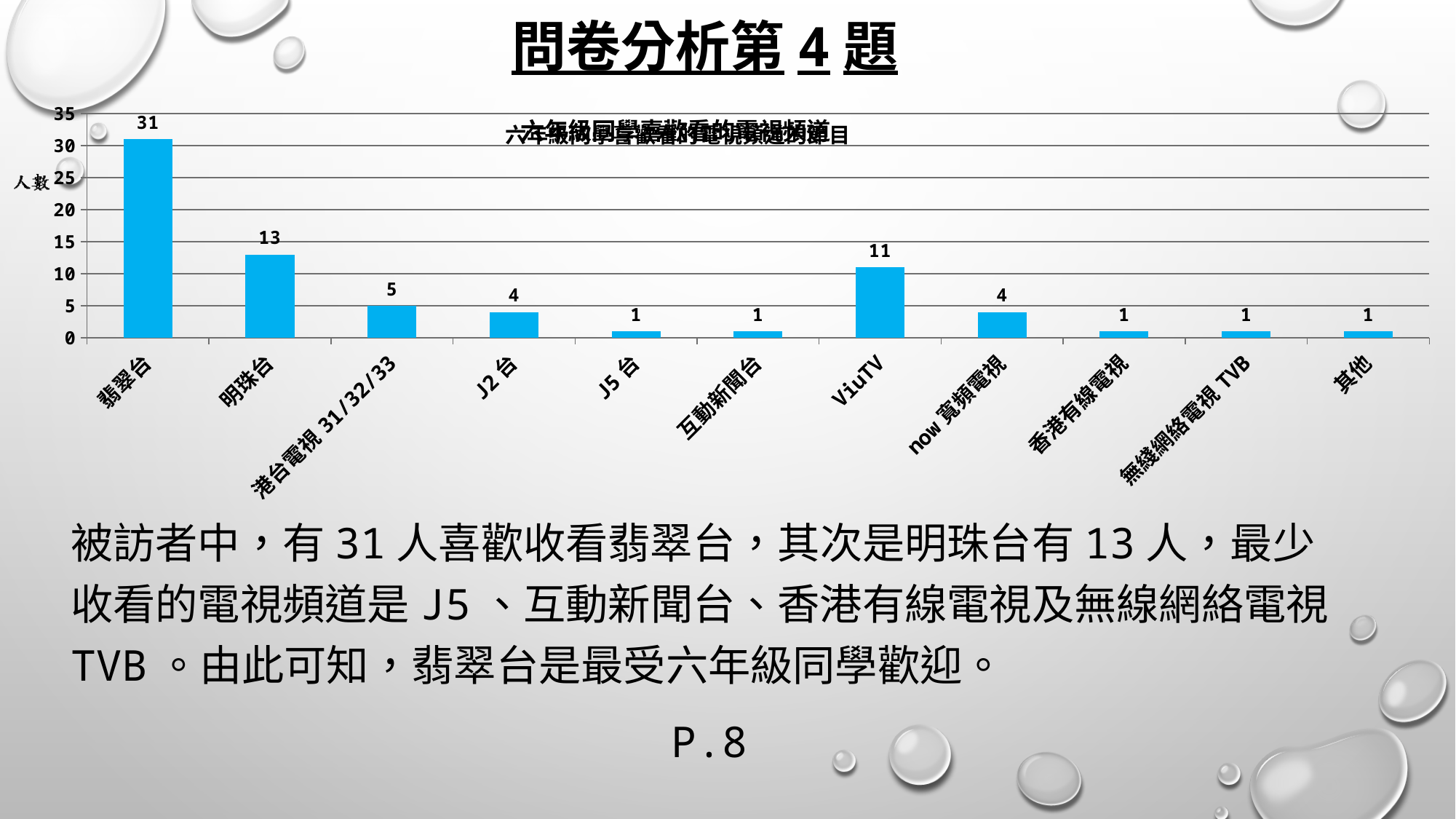
How many categories are shown on the x axis? 11 How many categories have a value of 1? 5 What is the label on the y axis? 人數 Which channel has the highest value? 翡翠台 How many people chose 翡翠台? 31 What is the difference between the values for 明珠台 and ViuTV? 2 What is the difference between the values for 翡翠台 and 明珠台? 18 What is the value for 明珠台? 13 What is the value for ViuTV? 11 What is the value for 港台電視 31/32/33? 5 Which has a larger value, J2台 or 港台電視 31/32/33? 港台電視 31/32/33 What type of chart is shown on the slide? bar chart